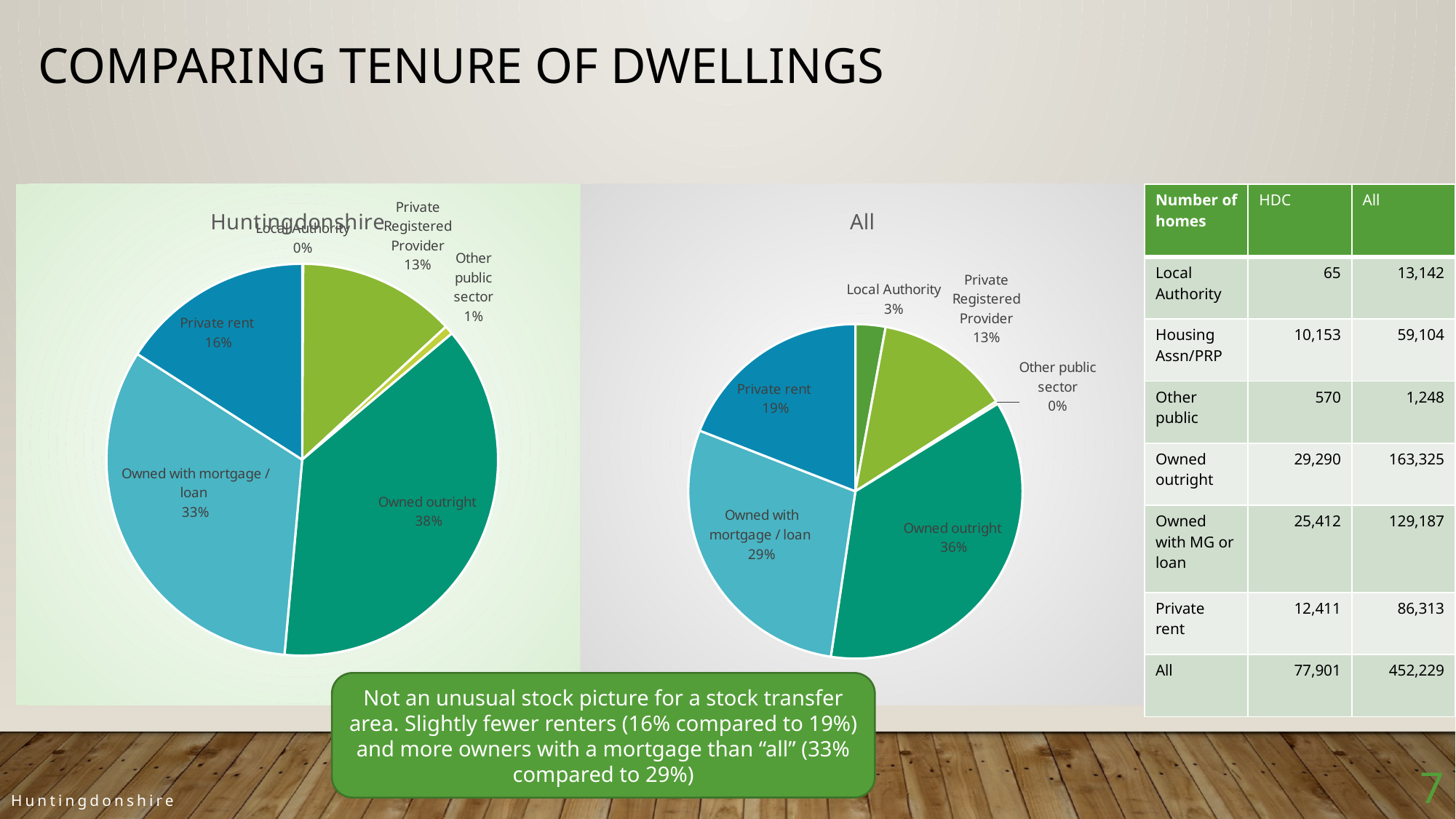
What is the title of the left pie chart? Huntingdonshire In the All pie chart, which category has the smallest share? Other public sector In the All pie chart, what share is Local Authority? 3% In the Huntingdonshire pie chart, what share is Owned with mortgage / loan? 33% What kind of chart is the All chart? Pie chart In the Huntingdonshire pie chart, which category has the largest share? Owned outright In the Huntingdonshire pie chart, what share is Private Registered Provider? 13% How many categories does the Huntingdonshire pie chart show? 6 In the All pie chart, which is larger: Owned with mortgage / loan or Private rent? Owned with mortgage / loan In the All pie chart, what share is Private rent? 19% In the Huntingdonshire pie chart, what is the difference between the Owned outright share and the Private rent share? 22% In the Huntingdonshire pie chart, what share is Owned outright? 38%